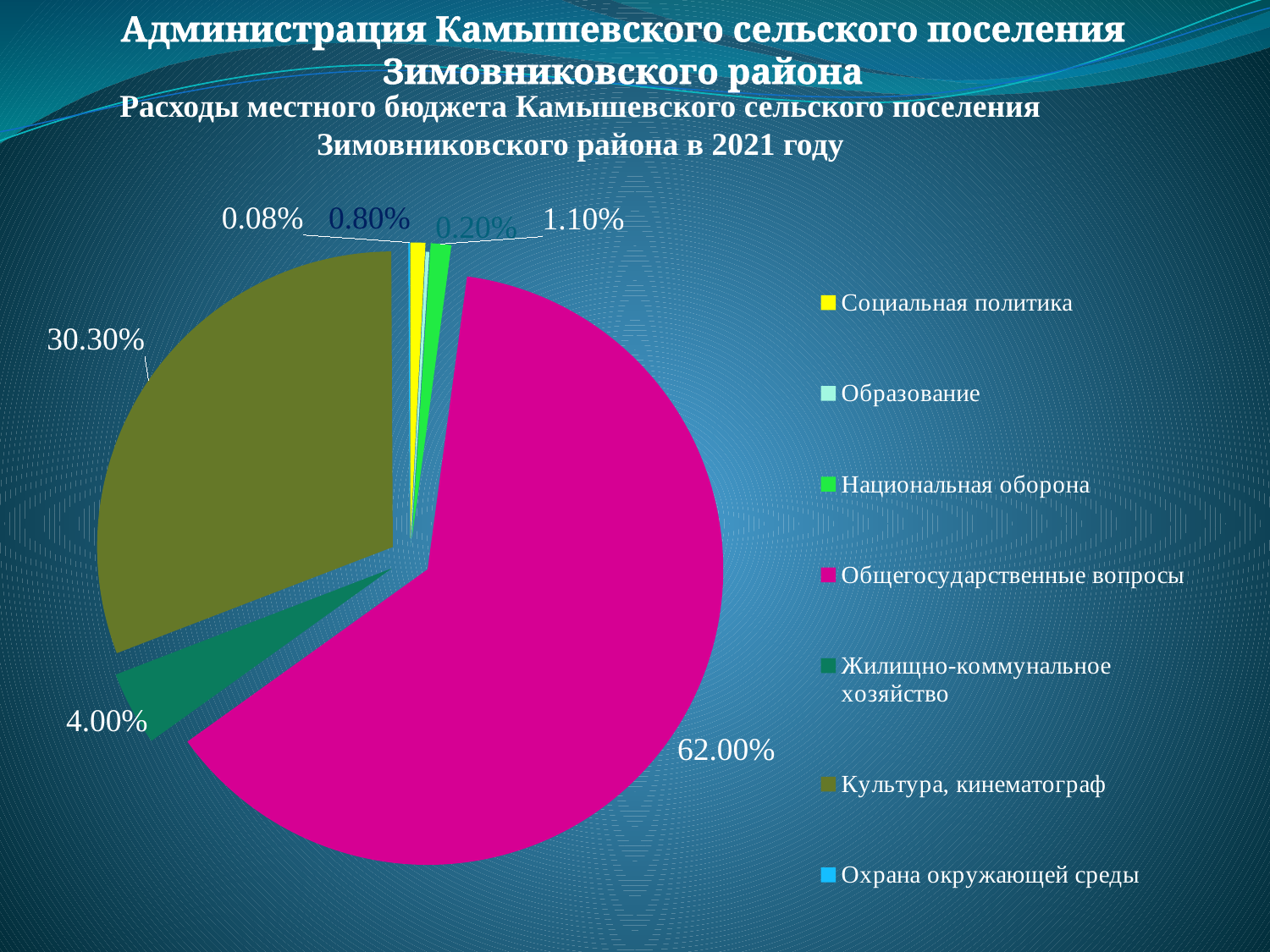
What share of the pie does Жилищно-коммунальное хозяйство have? 4.00% Which category has the smallest slice of the pie? Охрана окружающей среды Which category has the largest slice of the pie? Общегосударственные вопросы What year does the chart title say the budget expenditures are for? 2021 What share of the pie does Общегосударственные вопросы have? 62.00% What share of the pie does Культура, кинематограф have? 30.30% Which is larger, the share of Культура, кинематограф or the share of Жилищно-коммунальное хозяйство? Культура, кинематограф What colour is the slice for Общегосударственные вопросы? magenta What kind of chart is shown on the slide? pie chart What is the difference between the shares of Общегосударственные вопросы and Культура, кинематограф? 31.70% How many categories does the legend list? 7